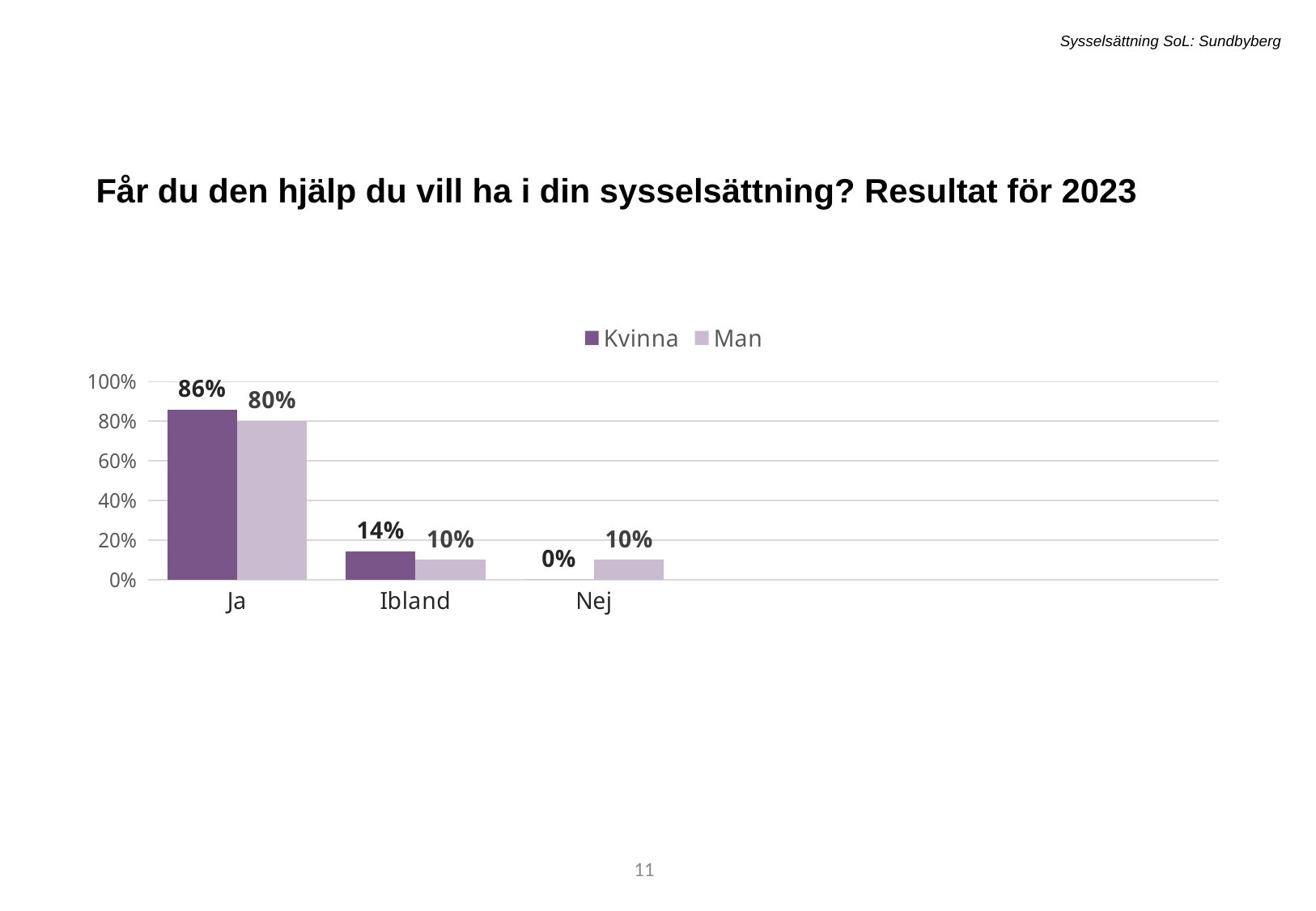
Which category has the lowest value for Man? Ibland and Nej (both 10%) How many categories are shown on the x axis? 3 In the Ibland category, which series has the larger value, Kvinna or Man? Kvinna What is the value for Kvinna in the Ibland category? 14% What is the difference between the Kvinna and Man values in the Ja category? 6 percentage points Which category has the highest value for Kvinna? Ja How many series does the legend list? 2 What kind of chart is shown on the slide? Bar chart What is the value for Man in the Nej category? 10% What is the value for Kvinna in the Nej category? 0% What is the value for Man in the Ja category? 80% What is the value for Kvinna in the Ja category? 86%